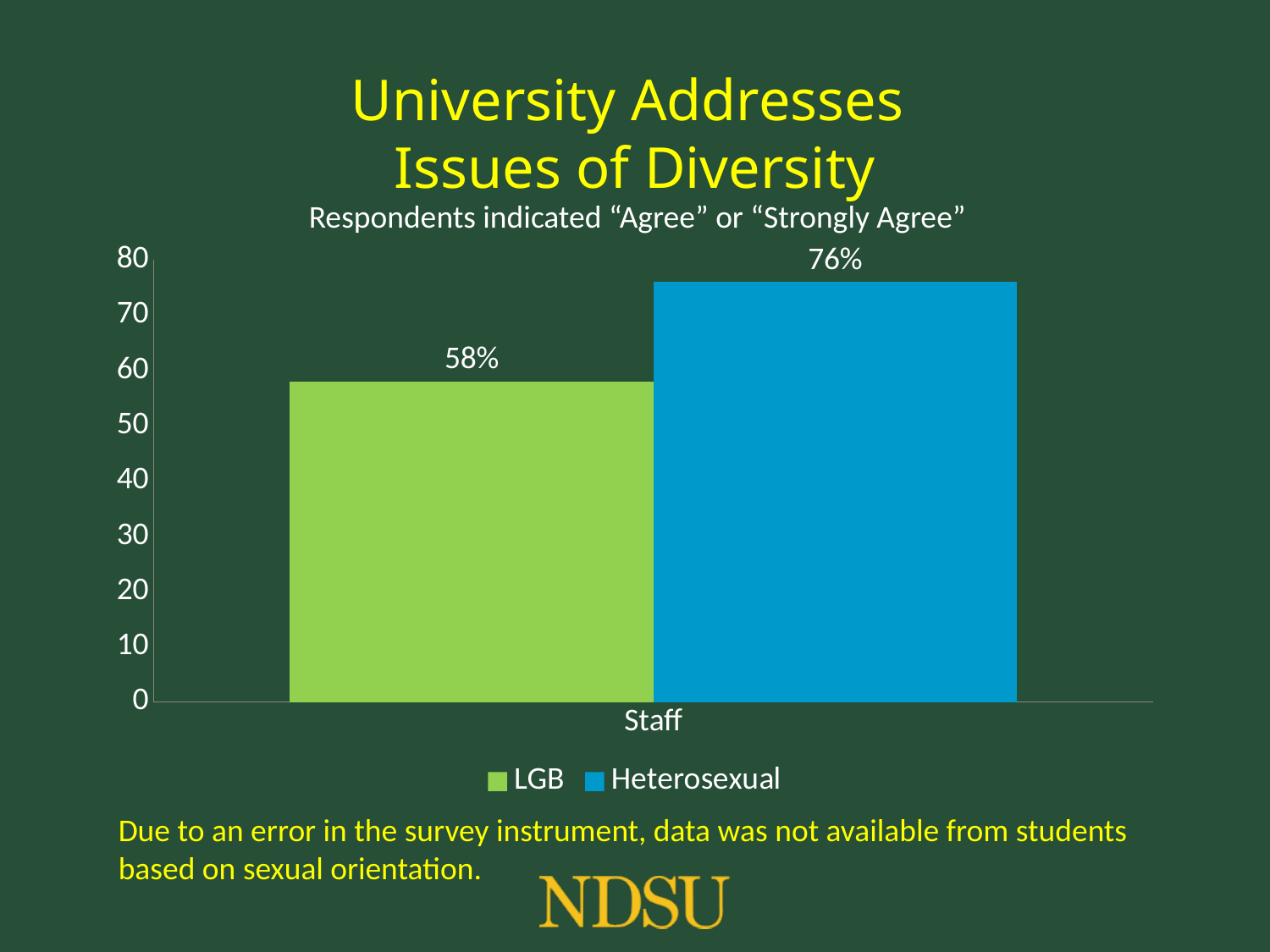
Which series has the lowest value on the chart? LGB How many series does the legend list? 2 Is the value for Heterosexual greater or less than 70? greater What kind of chart is shown on the slide? Bar chart What is the difference between the Heterosexual and LGB values for Staff? 18% Is the value for LGB greater or less than 60? less What is the value for LGB staff? 58% How many categories are shown on the x axis? 1 Which series has the higher value for Staff, LGB or Heterosexual? Heterosexual What is the title of the chart? University Addresses Issues of Diversity What colour is the bar for the Heterosexual series? Blue What is the value for Heterosexual staff? 76%